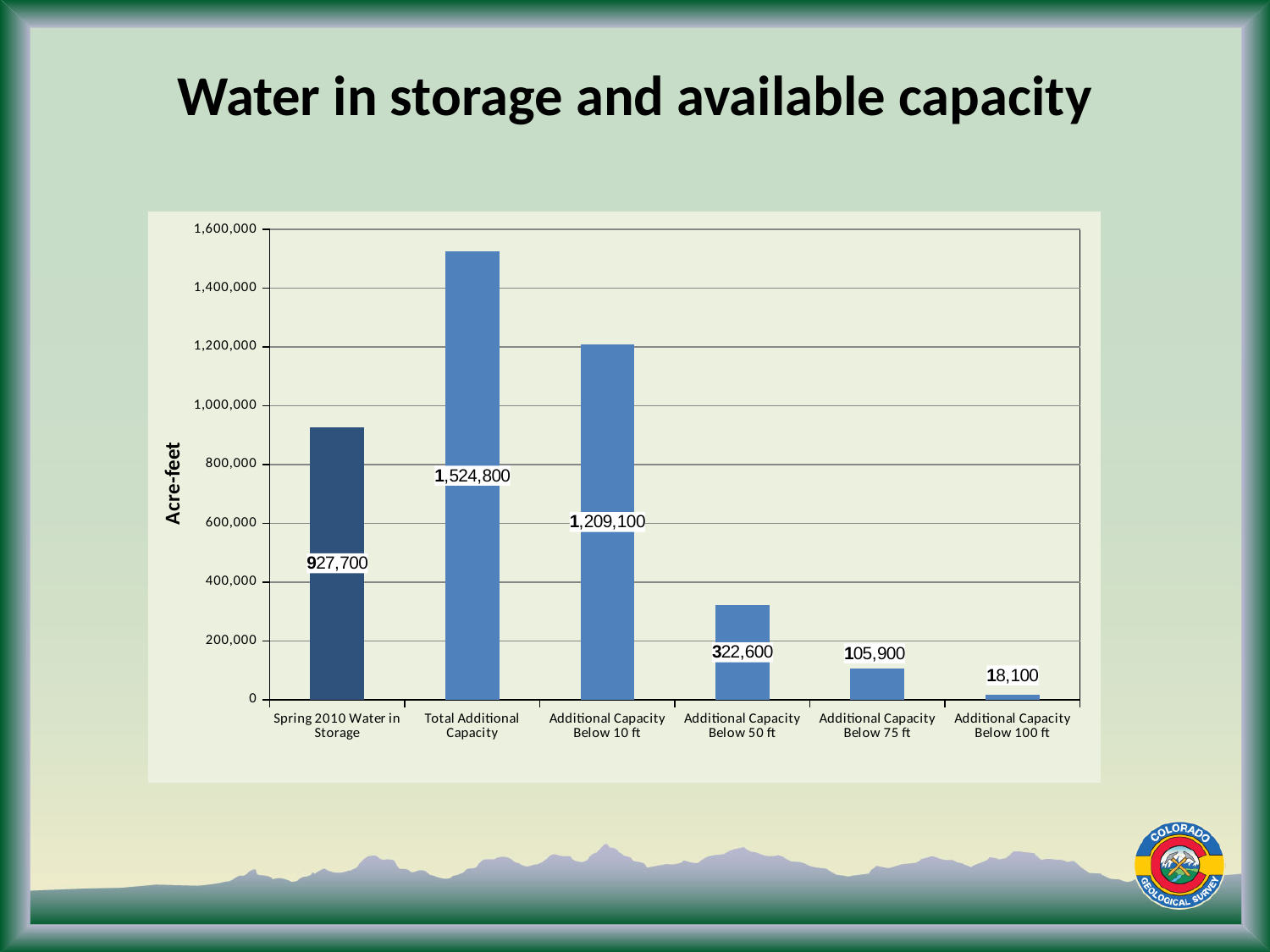
What is the value for Additional Capacity Below 50 ft? 322,600 What is the value for Spring 2010 Water in Storage? 927,700 How many categories are shown on the x axis? 6 What is the difference between Total Additional Capacity and Additional Capacity Below 10 ft? 315,700 What is the value for Total Additional Capacity? 1,524,800 Which category has the highest value? Total Additional Capacity Is the value for Spring 2010 Water in Storage greater or less than 1,000,000? less Which is larger, Additional Capacity Below 50 ft or Additional Capacity Below 75 ft? Additional Capacity Below 50 ft Which category has the lowest value? Additional Capacity Below 100 ft What is the value for Additional Capacity Below 10 ft? 1,209,100 What is the value for Additional Capacity Below 100 ft? 18,100 What kind of chart is shown on the slide? Bar chart